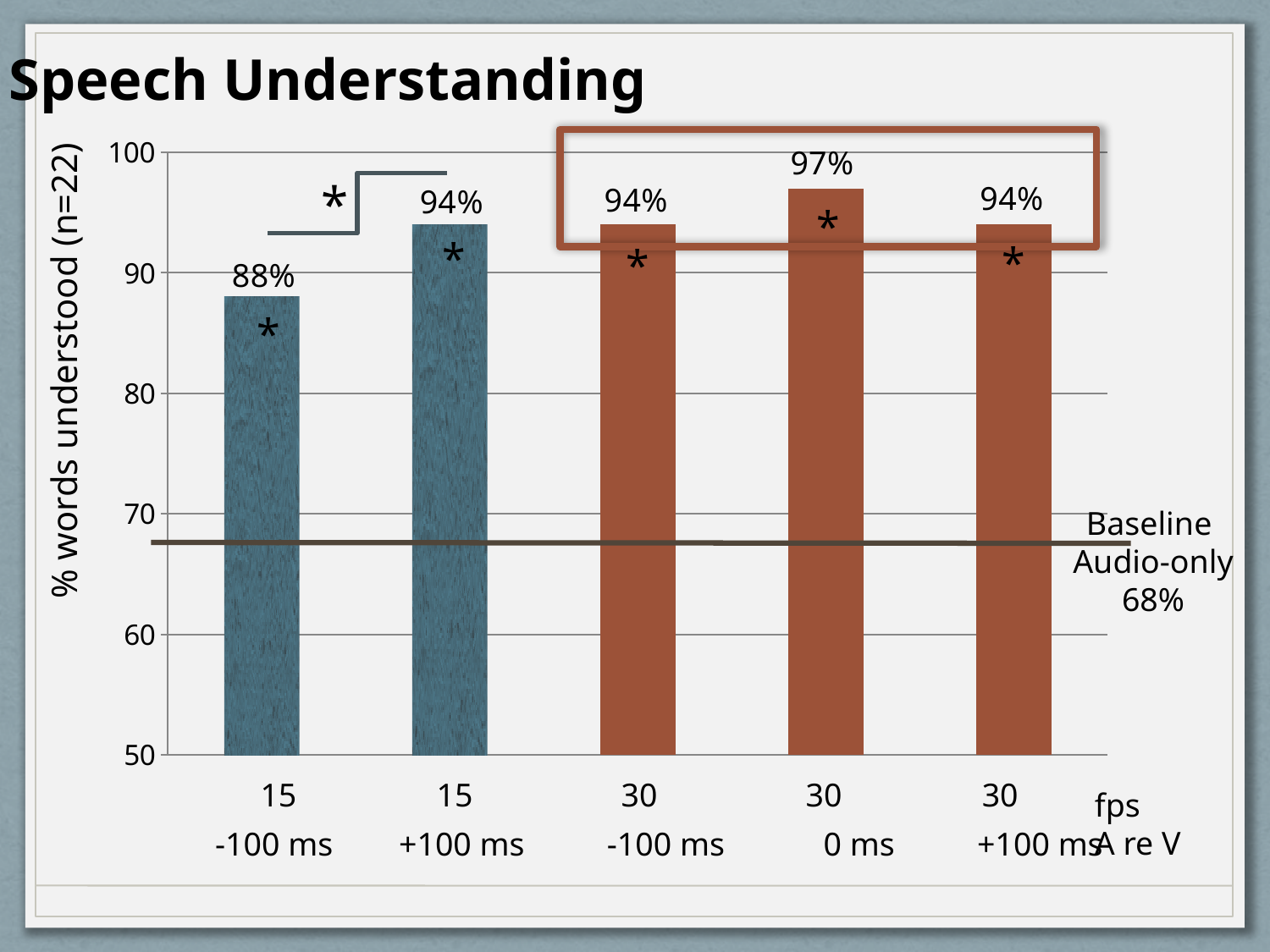
Which condition has the lowest percentage of words understood? 15 fps, -100 ms How many bars are plotted in the chart? 5 What is the label of the y axis? % words understood (n=22) Which is larger, the value for 15 fps, -100 ms or the value for 15 fps, +100 ms? 15 fps, +100 ms What kind of chart is shown on the slide? bar chart What is the difference between the 30 fps, 0 ms value and the 15 fps, -100 ms value? 9% Is the value for the 15 fps, -100 ms condition greater or less than 90? less Which condition has the highest percentage of words understood? 30 fps, 0 ms What is the value for the 15 fps, -100 ms condition? 88% What is the value for the 15 fps, +100 ms condition? 94% What is the baseline audio-only value shown by the horizontal line? 68% What is the value for the 30 fps, 0 ms condition? 97%